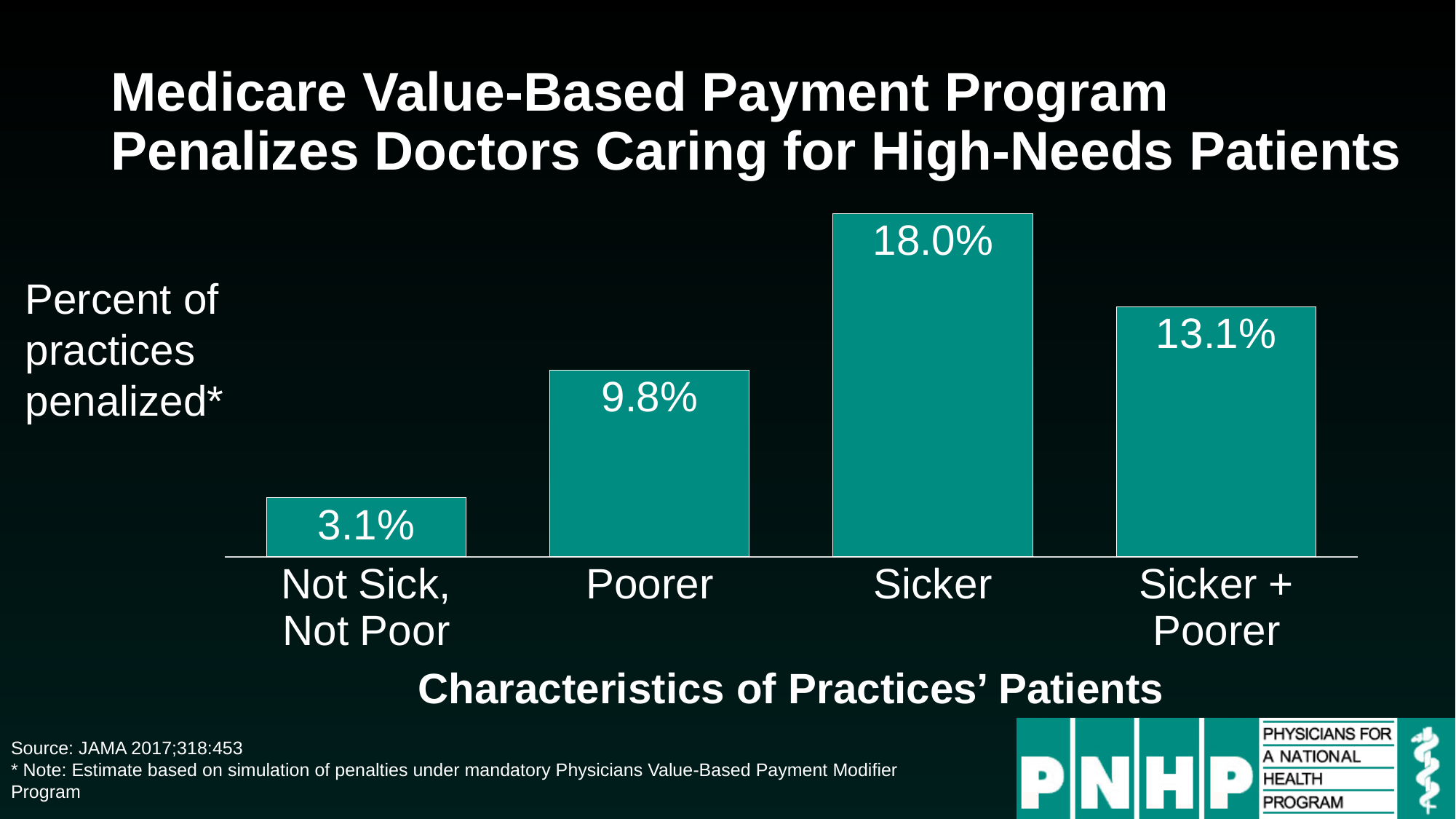
What percent of practices with 'Not Sick, Not Poor' patients are penalized? 3.1% How many patient characteristic categories are shown in the chart? 4 What percent of practices with 'Sicker' patients are penalized? 18.0% What percent of practices with 'Sicker + Poorer' patients are penalized? 13.1% Which has a higher percent of practices penalized, 'Poorer' or 'Sicker + Poorer'? Sicker + Poorer Which patient characteristic category has the highest percent of practices penalized? Sicker What is the difference in percent of practices penalized between 'Sicker' and 'Not Sick, Not Poor'? 14.9% What kind of chart is shown on the slide? Bar chart What is the label of the x axis of the chart? Characteristics of Practices' Patients What is the difference in percent of practices penalized between 'Sicker + Poorer' and 'Poorer'? 3.3% What percent of practices with 'Poorer' patients are penalized? 9.8% Which patient characteristic category has the lowest percent of practices penalized? Not Sick, Not Poor